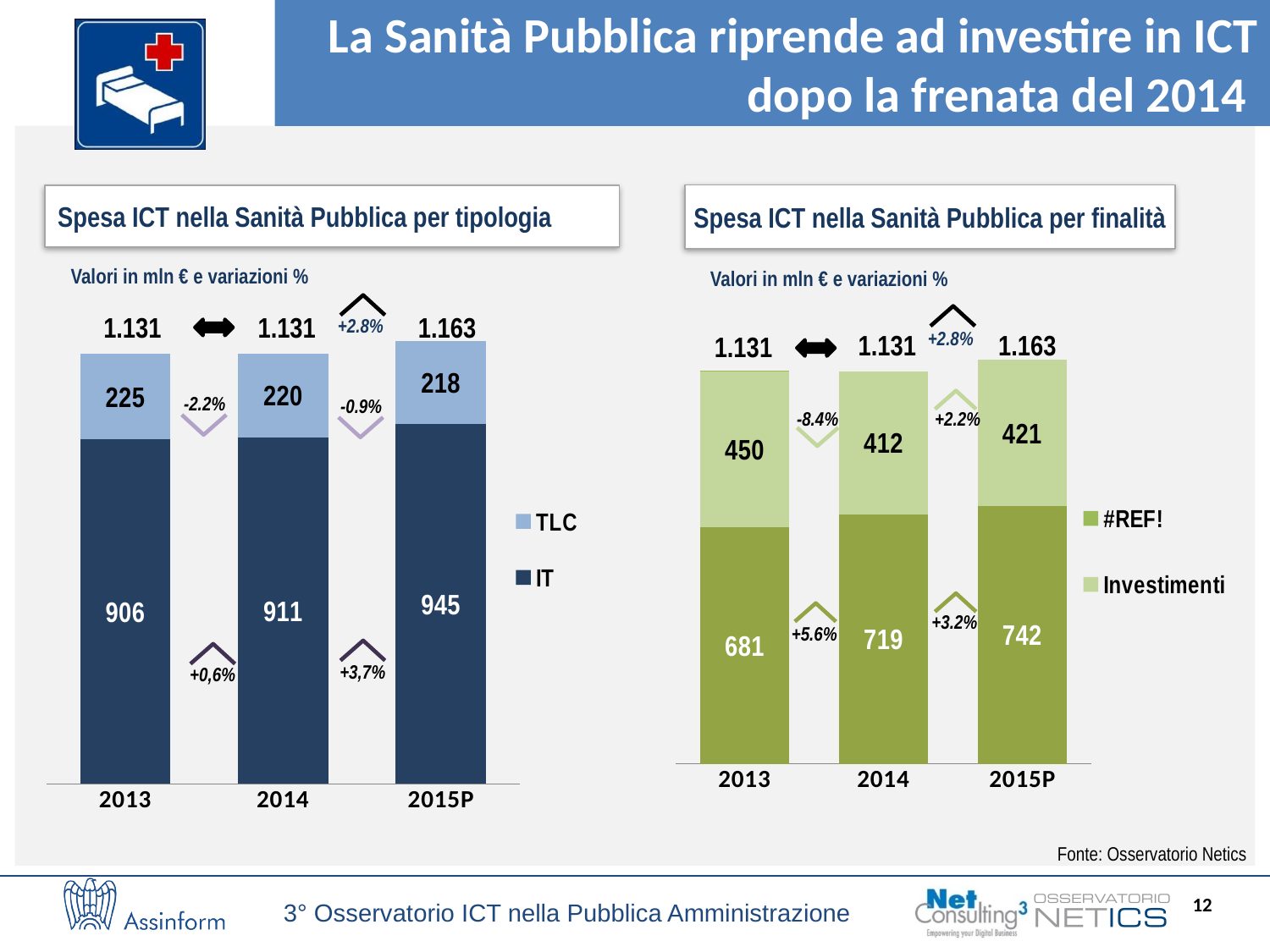
In the chart 'Spesa ICT nella Sanità Pubblica per finalità', which year has the highest Investimenti value? 2013 In the chart 'Spesa ICT nella Sanità Pubblica per finalità', what is the value of the bottom (dark green) segment for 2015P? 742 In the chart 'Spesa ICT nella Sanità Pubblica per tipologia', which year has the lowest TLC value? 2015P In the chart 'Spesa ICT nella Sanità Pubblica per tipologia', what is the difference between the IT values for 2015P and 2014? 34 In the chart 'Spesa ICT nella Sanità Pubblica per tipologia', how many series does the legend list? 2 In the chart 'Spesa ICT nella Sanità Pubblica per tipologia', what is the total of the stacked bar for 2015P? 1.163 In the chart 'Spesa ICT nella Sanità Pubblica per tipologia', what is the TLC value for 2013? 225 In the chart 'Spesa ICT nella Sanità Pubblica per tipologia', does the IT value rise or fall from 2013 to 2015P? rise In the chart 'Spesa ICT nella Sanità Pubblica per finalità', how many years are shown on the x axis? 3 What kind of chart is 'Spesa ICT nella Sanità Pubblica per finalità'? stacked bar chart In the chart 'Spesa ICT nella Sanità Pubblica per finalità', what is the Investimenti value for 2014? 412 In the chart 'Spesa ICT nella Sanità Pubblica per tipologia', what is the IT value for 2015P? 945